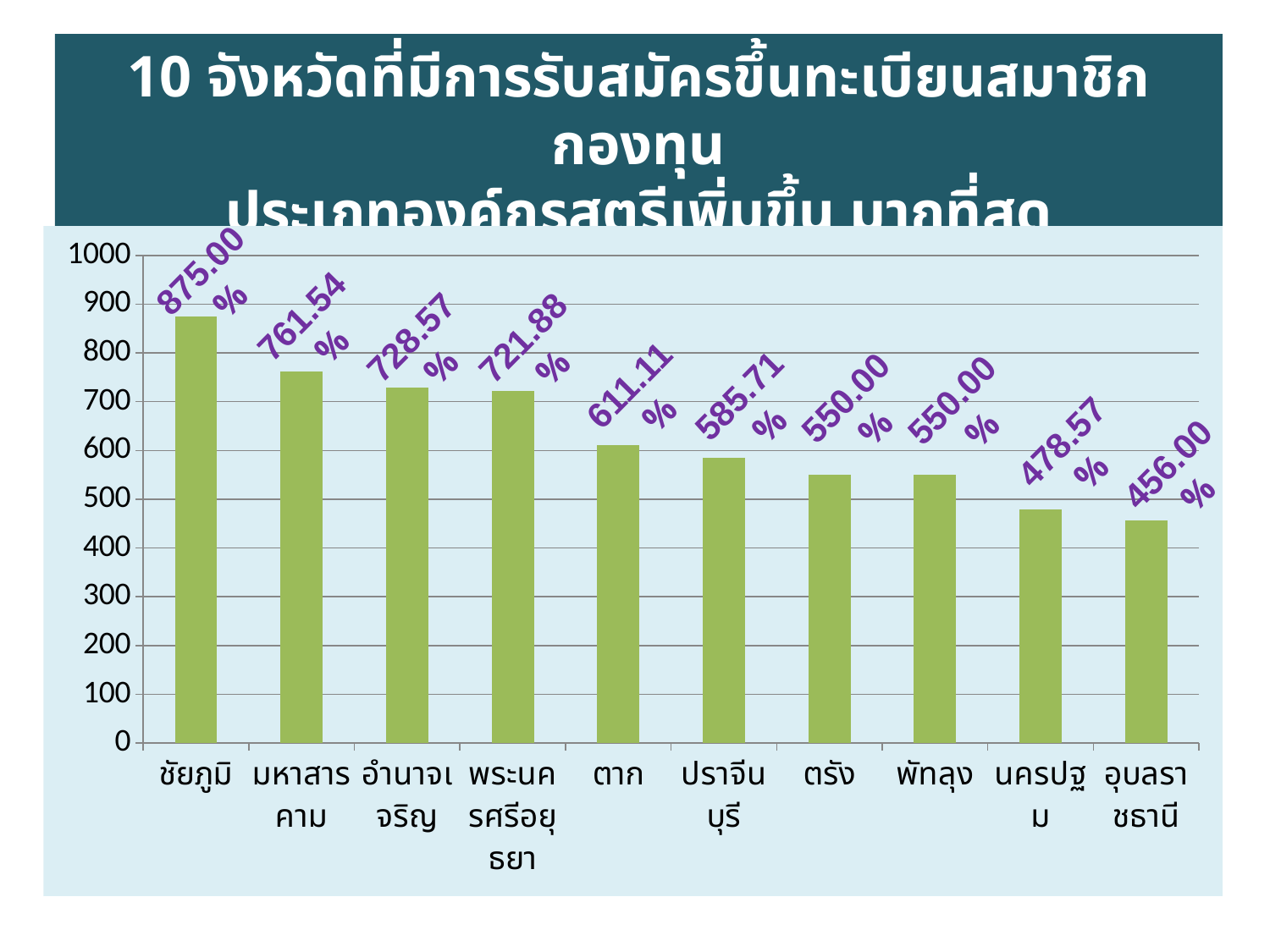
What is the value for นครปฐม? 478.57% Which is larger, the value for อำนาจเจริญ or the value for ปราจีนบุรี? อำนาจเจริญ What type of chart is shown on the slide? bar chart Do the values rise or fall moving from left to right along the x axis? fall What is the difference between the values for ชัยภูมิ and อุบลราชธานี? 419.00% How many provinces (categories) are plotted in the chart? 10 What is the value for มหาสารคาม? 761.54% Which province has the lowest value in the chart? อุบลราชธานี Which two provinces share the same value of 550.00%? ตรัง and พัทลุง What is the value for ตาก? 611.11% What is the value for ชัยภูมิ? 875.00% Which province has the highest value in the chart? ชัยภูมิ